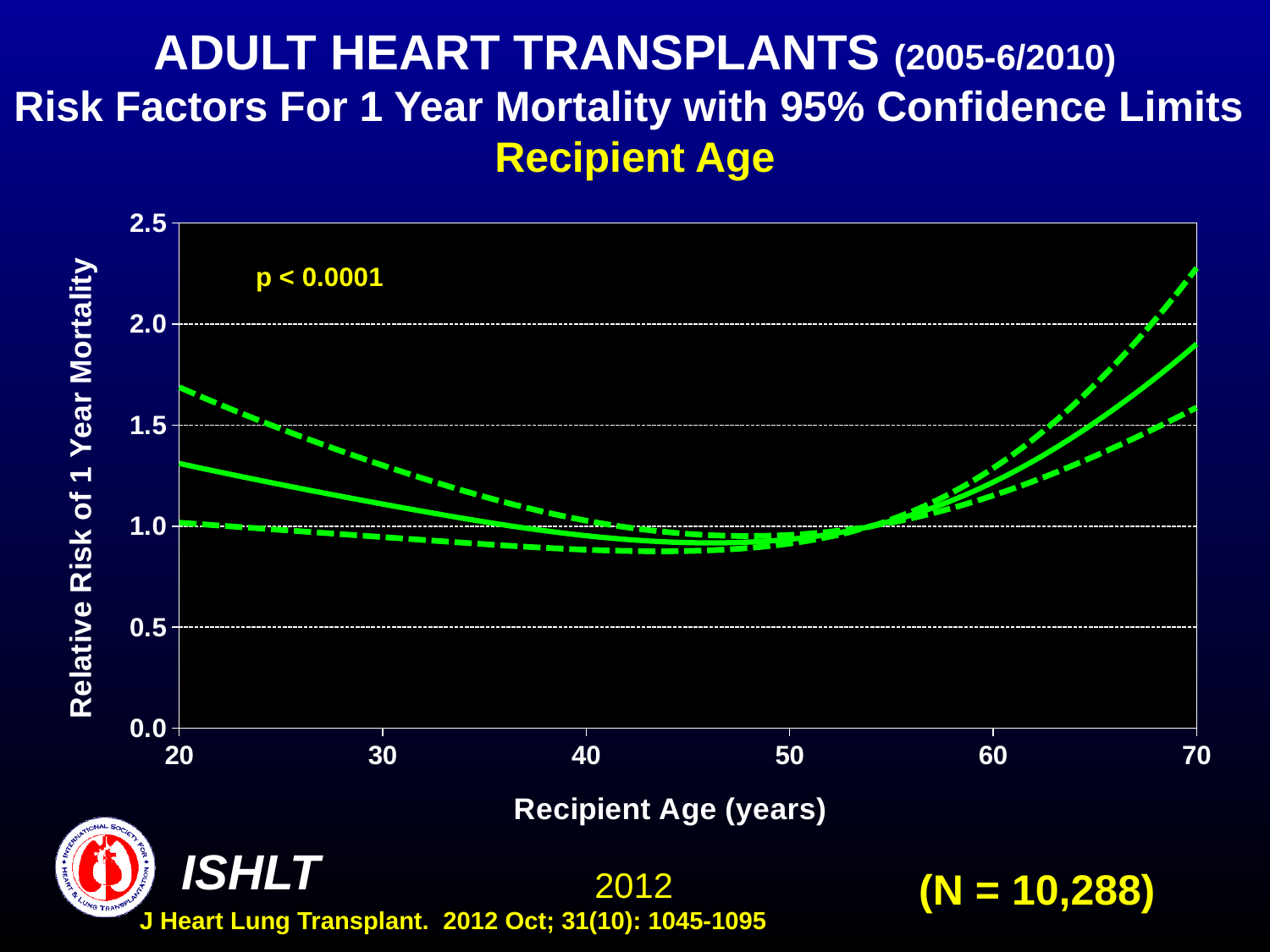
How many lines are plotted on the chart? 3 Is the lower dashed confidence limit at recipient age 45 greater or less than 1.0? less Is the relative risk on the solid line at recipient age 20 greater or less than 1.0? greater What p-value is printed on the chart? p < 0.0001 What kind of chart is shown on the slide? line chart What is the label of the x axis? Recipient Age (years) Is the relative risk on the solid line at recipient age 70 greater or less than 1.5? greater Which is larger on the solid line: the relative risk at recipient age 70 or at recipient age 20? age 70 Does the solid line rise or fall as recipient age increases from 20 to 45? fall Does the solid line rise or fall as recipient age increases from 55 to 70? rise